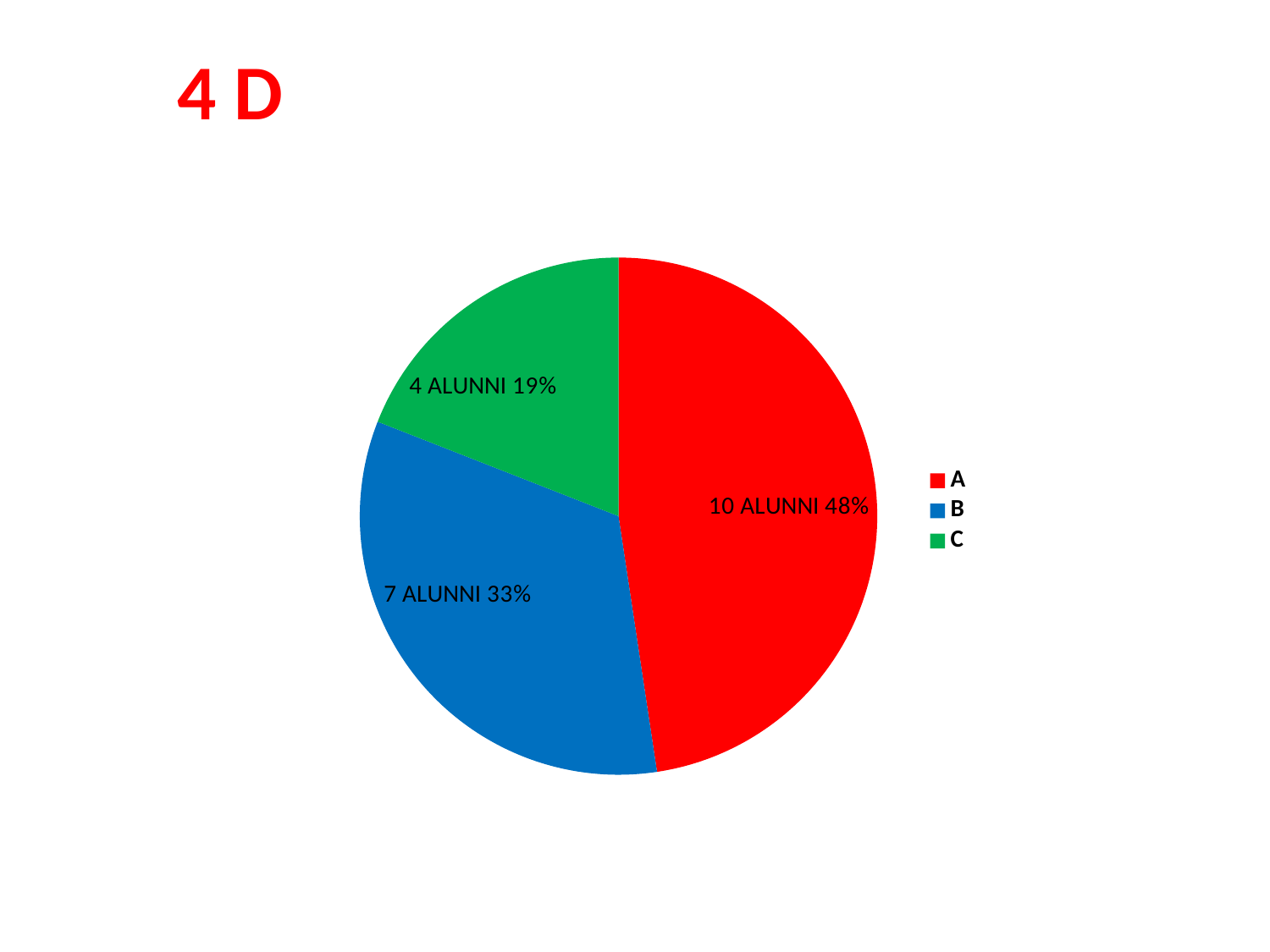
How many alunni are in category C? 4 ALUNNI How many entries does the legend list? 3 What kind of chart is shown on the slide? pie chart How many slices does the pie chart have? 3 Which category has the smallest slice? C What percentage share does slice B have? 33% What is the difference in number of alunni between category A and category C? 6 What percentage share does slice C have? 19% How many alunni are in category A? 10 ALUNNI What percentage share does slice A have? 48% Which category has the largest slice? A How many alunni are in category B? 7 ALUNNI